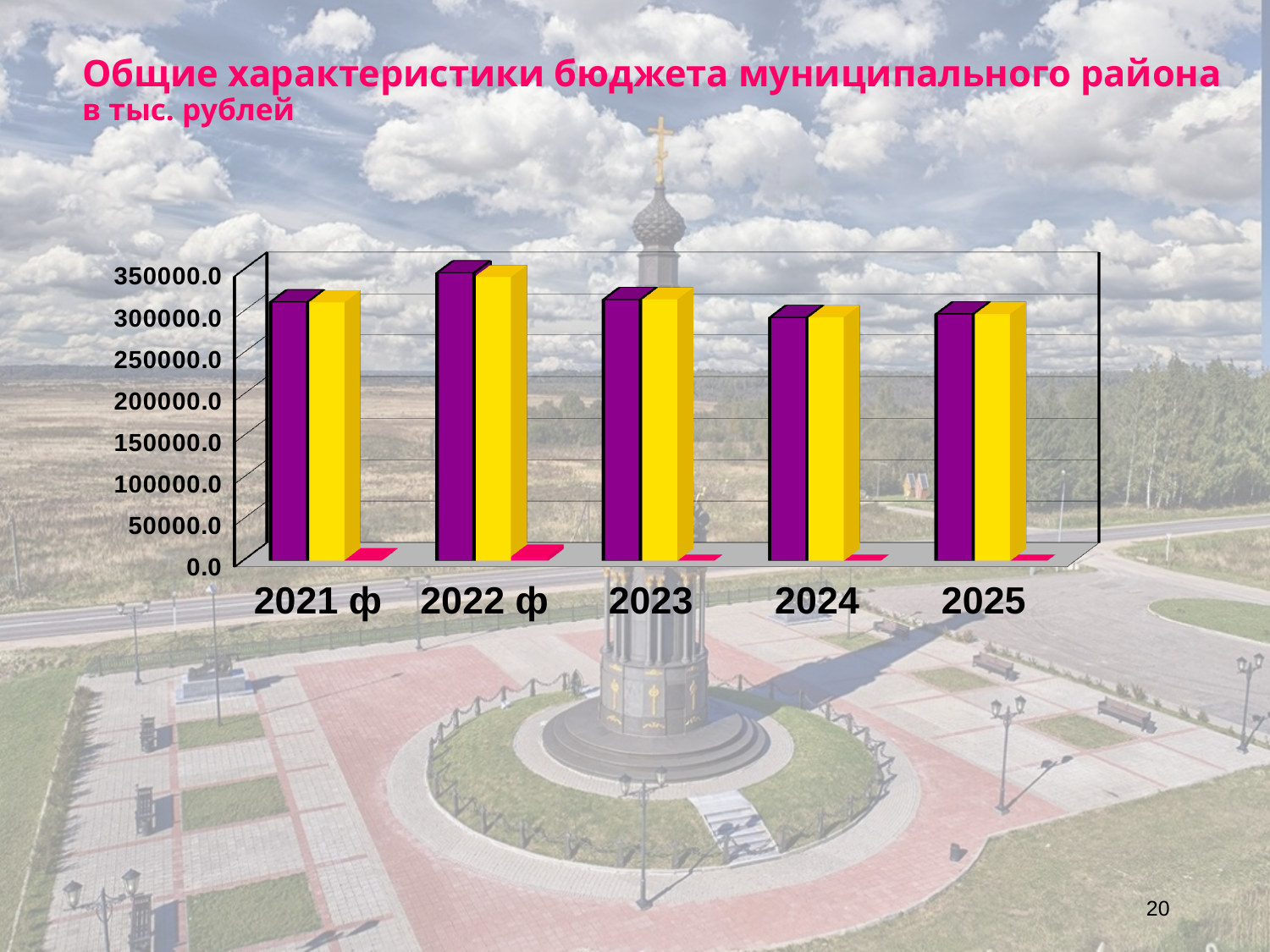
In what units are the values on the chart expressed, according to the subtitle? в тыс. рублей What is the title of the chart on the slide? Общие характеристики бюджета муниципального района Is the yellow bar for 2021 ф greater or less than 250000.0? greater What kind of chart is shown on the slide? bar chart Is the purple bar for 2024 greater or less than 350000.0? less Which category has the tallest yellow bar? 2022 ф Which is larger: the purple bar for 2022 ф or the purple bar for 2024? 2022 ф Which is larger: the yellow bar for 2021 ф or the yellow bar for 2022 ф? 2022 ф How many categories are shown on the x axis of the chart? 5 Is the pink bar for 2023 greater or less than 50000.0? less Which category has the tallest purple bar? 2022 ф